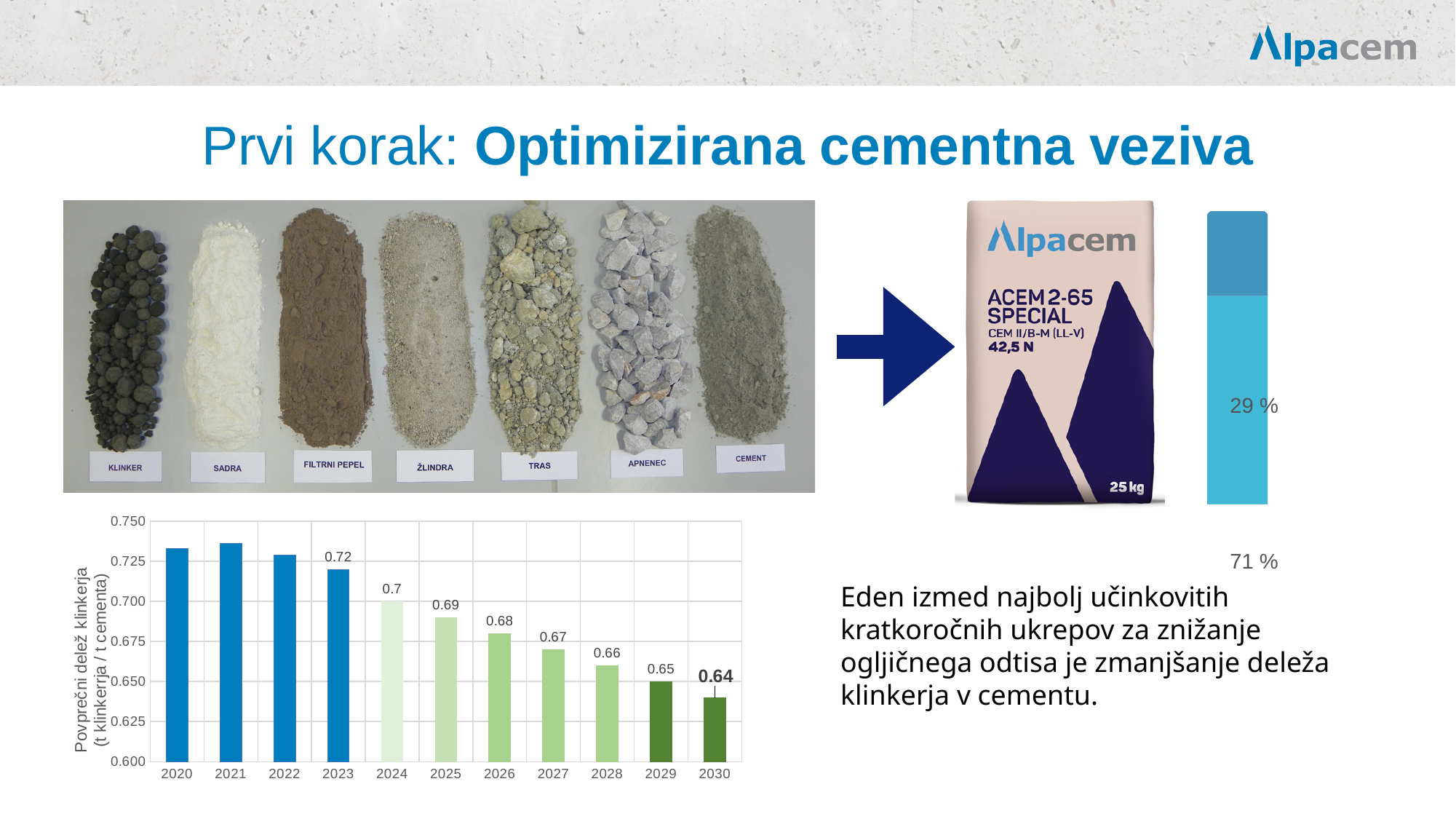
In the bar chart of average clinker share by year, do the values rise or fall from 2023 to 2030? fall What kind of chart is the chart at the bottom left of the slide? bar chart In the bar chart of average clinker share by year, which year has the lowest value? 2030 In the bar chart of average clinker share by year, what is the difference between the values for 2023 and 2030? 0.08 In the bar chart of average clinker share by year, what is the value for 2023? 0.72 In the bar chart of average clinker share by year, which is larger, the value for 2025 or the value for 2028? 2025 In the bar chart of average clinker share by year, what is the value for 2026? 0.68 In the bar chart of average clinker share by year, is the value for 2021 greater or less than 0.725? greater In the bar chart of average clinker share by year, what is the difference between the values for 2024 and 2025? 0.01 In the bar chart of average clinker share by year, is the value for 2020 greater or less than 0.725? greater In the bar chart of average clinker share by year, how many years are shown on the x axis? 11 In the bar chart of average clinker share by year, what is the value for 2030? 0.64